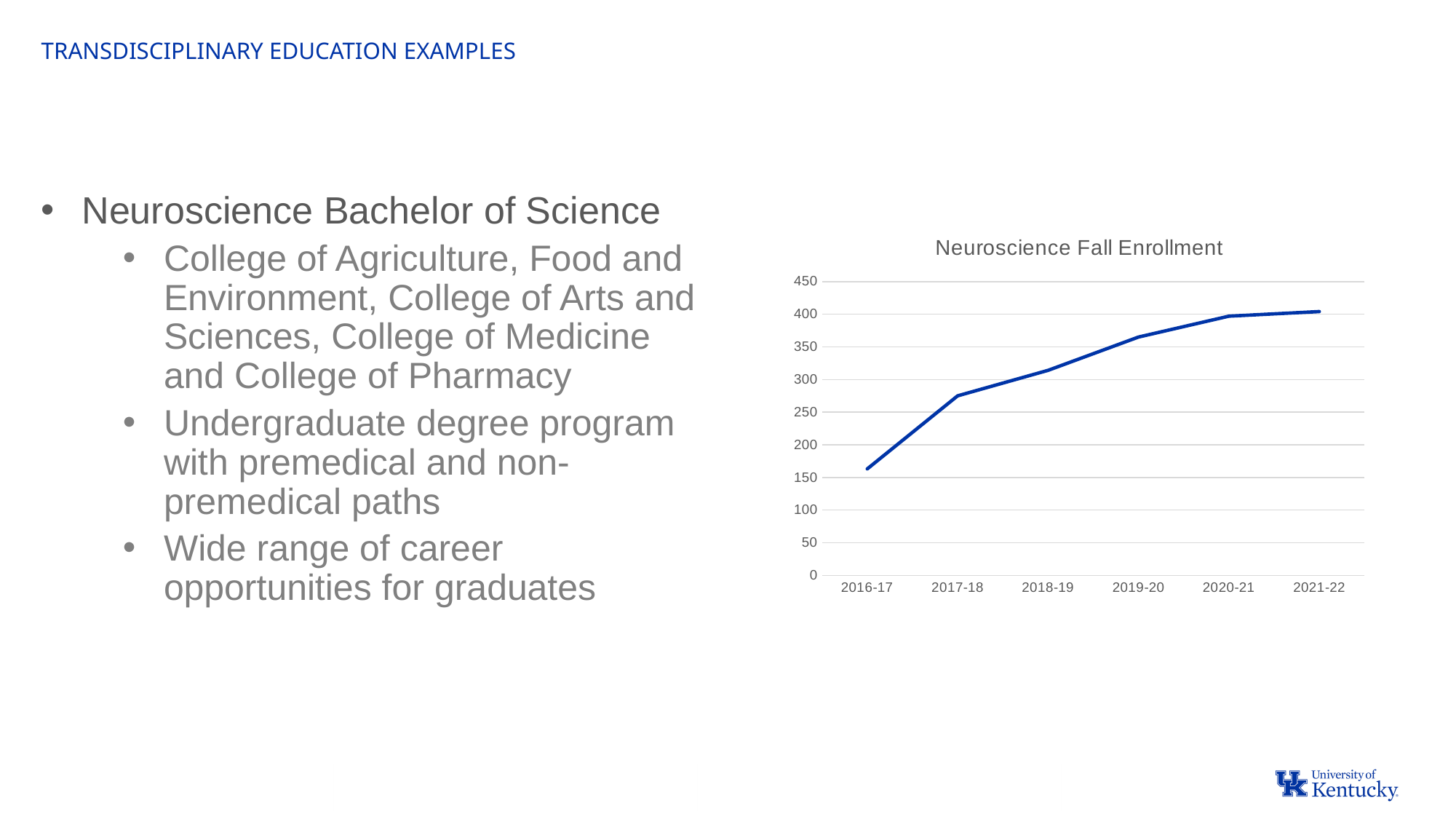
What is the highest value shown on the y axis of the chart? 450 Is the enrollment value for 2016-17 greater or less than 150? greater Which year has higher Neuroscience fall enrollment, 2017-18 or 2019-20? 2019-20 Which academic year has the lowest Neuroscience fall enrollment? 2016-17 Does Neuroscience fall enrollment rise or fall from 2016-17 to 2021-22? rise What is the title of the chart? Neuroscience Fall Enrollment Is the enrollment value for 2017-18 greater or less than 250? greater Is the enrollment value for 2016-17 greater or less than 200? less How many academic years are plotted on the x axis of the chart? 6 What kind of chart is shown on the slide? line chart